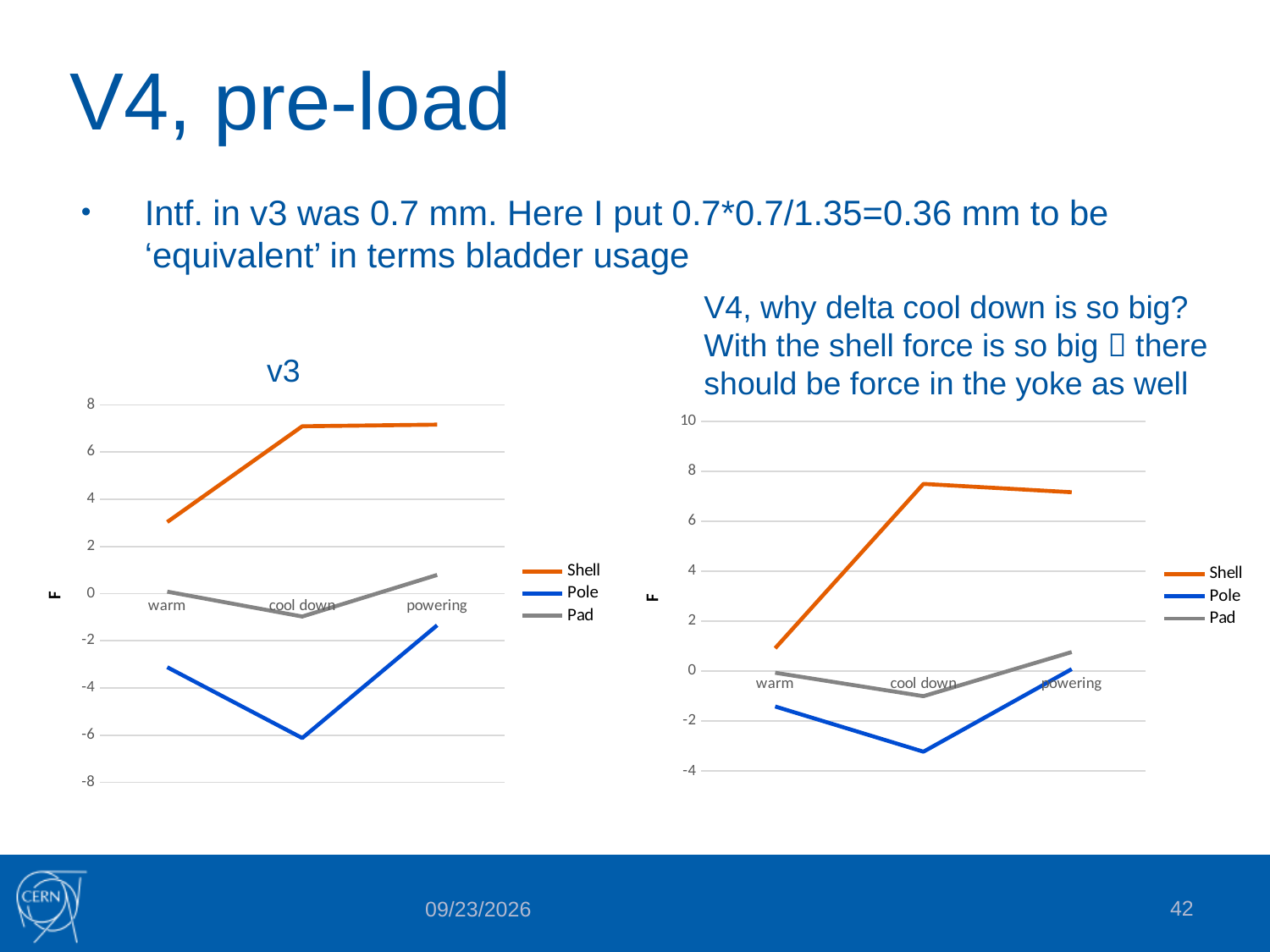
In the chart on the right, which colour is used for the Pad series? grey In the chart on the right, how many categories are shown on the x axis? 3 In the v3 chart on the left, which series has the highest value at cool down? Shell In the v3 chart on the left, does the Pole series rise or fall from warm to cool down? fall In the v3 chart on the left, is the Shell value at cool down greater or less than 6? greater In the chart on the right, is the Shell value at warm greater or less than 2? less In the v3 chart on the left, which series has the lowest value at cool down? Pole In the chart on the right, which is larger: the Shell value at warm or the Shell value at cool down? cool down In the v3 chart on the left, what kind of chart is shown? line chart In the v3 chart on the left, how many series does the legend list? 3 In the chart on the right, is the Pole value at cool down greater or less than -2? less